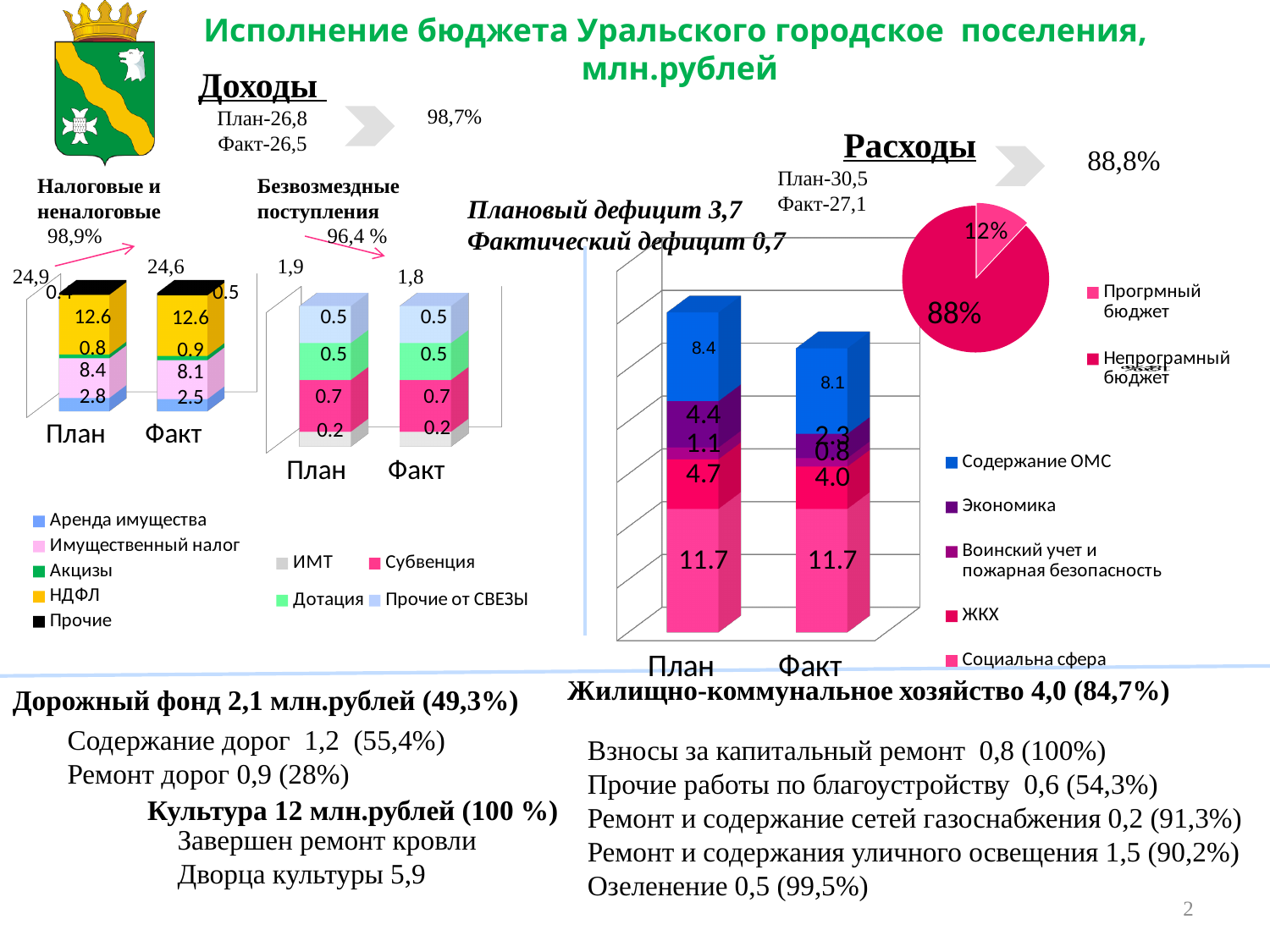
In the 'Налоговые и неналоговые' chart, what is the value of Аренда имущества for Факт? 2.5 In the 'Безвозмездные поступления' chart, which series has the smallest value for Факт? ИМТ In the 'Расходы' stacked bar chart, is ЖКХ larger for План or for Факт? План In the 'Безвозмездные поступления' chart, what is the value of Субвенция for План? 0.7 In the 'Налоговые и неналоговые' chart, how many series does the legend list? 5 What type of chart is the 'Расходы' chart with План and Факт? Stacked bar chart In the 'Расходы' stacked bar chart, which series has the largest value for План? Социальна сфера In the pie chart, what share does the larger slice have? 88% In the 'Налоговые и неналоговые' chart, what is the difference between Имущественный налог for План and for Факт? 0.3 In the 'Налоговые и неналоговые' chart, what is the value of НДФЛ for План? 12.6 In the 'Расходы' stacked bar chart, what is the value of Содержание ОМС for Факт? 8.1 In the 'Расходы' stacked bar chart, what is the difference between Экономика for План and for Факт? 2.1